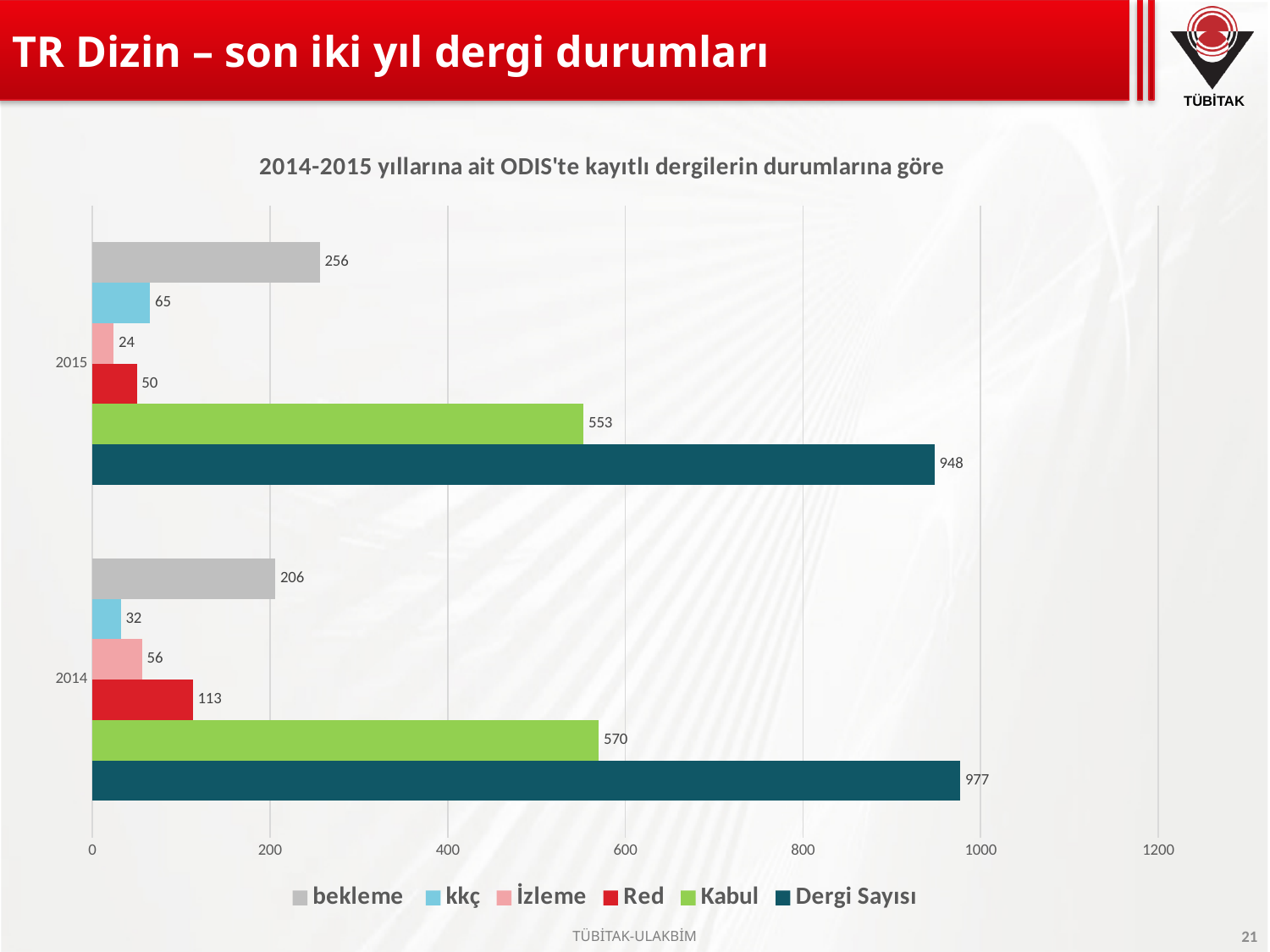
How many series does the legend list? 6 Which is larger, kkç for 2015 or kkç for 2014? kkç for 2015 How many year categories are shown on the chart? 2 What is the title of the chart? 2014-2015 yıllarına ait ODIS'te kayıtlı dergilerin durumlarına göre What is the value of Red for 2014? 113 What is the value of Kabul for 2014? 570 What is the value of Dergi Sayısı for 2015? 948 What is the value of bekleme for 2015? 256 Which series has the lowest value for 2015? İzleme What kind of chart is shown on the slide? Bar chart Which series has the highest value for 2014? Dergi Sayısı What is the difference between Dergi Sayısı for 2014 and 2015? 29